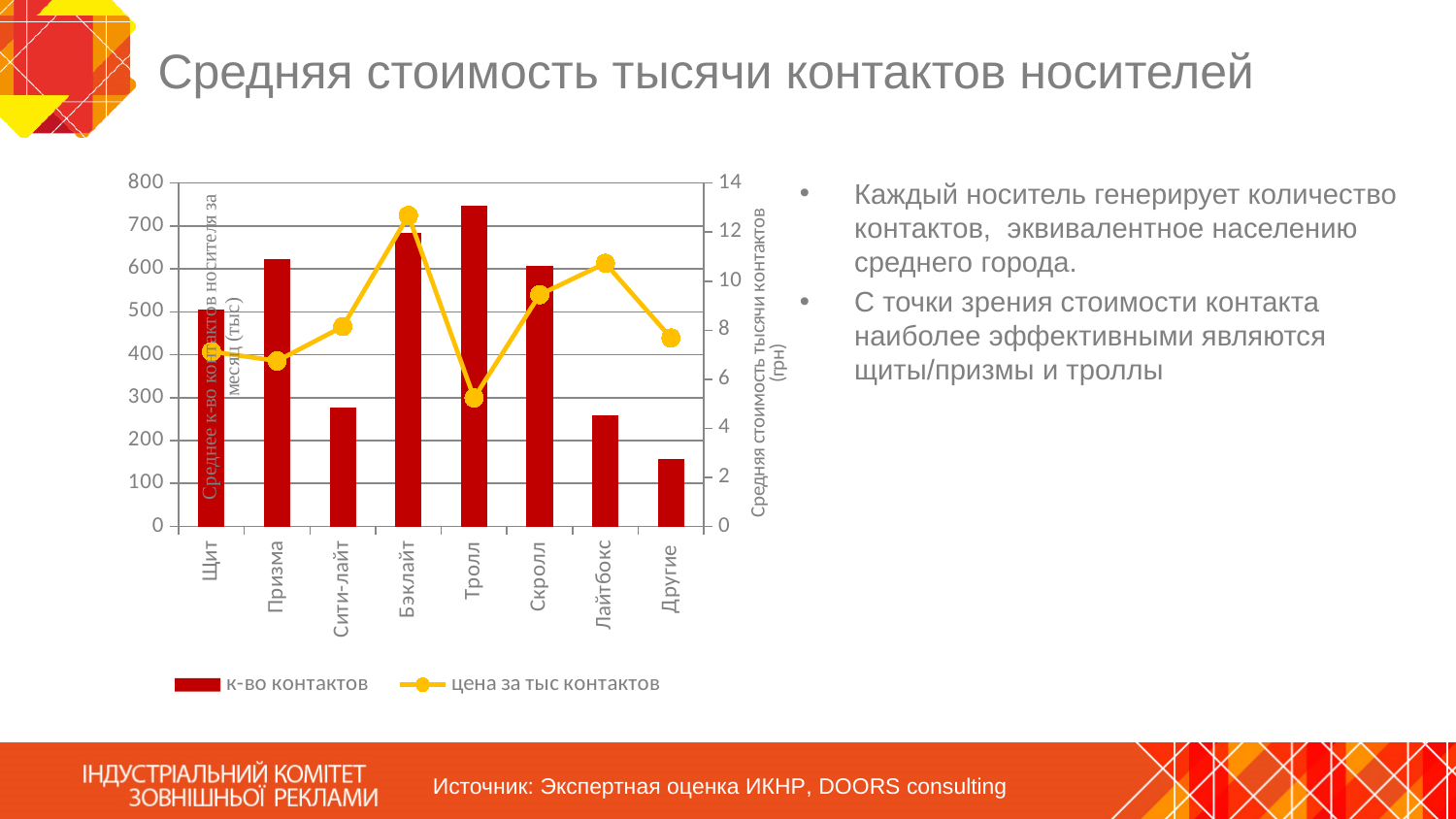
How many series does the chart legend list? 2 Which category has the lowest value on the 'цена за тыс контактов' line? Тролл Is the 'цена за тыс контактов' value for Бэклайт greater or less than 12? greater What is the title of the chart slide? Средняя стоимость тысячи контактов носителей Which category has the lowest bar for 'к-во контактов'? Другие What kind of chart is shown on the slide? Combined bar and line chart Which has the larger 'к-во контактов' bar, Щит or Лайтбокс? Щит Is the 'к-во контактов' value for Сити-лайт greater or less than 300? less Which category has the highest bar for 'к-во контактов'? Тролл Is the 'к-во контактов' value for Призма greater or less than 500? greater Which category has the highest value on the 'цена за тыс контактов' line? Бэклайт How many categories (media types) are shown on the x axis of the chart? 8